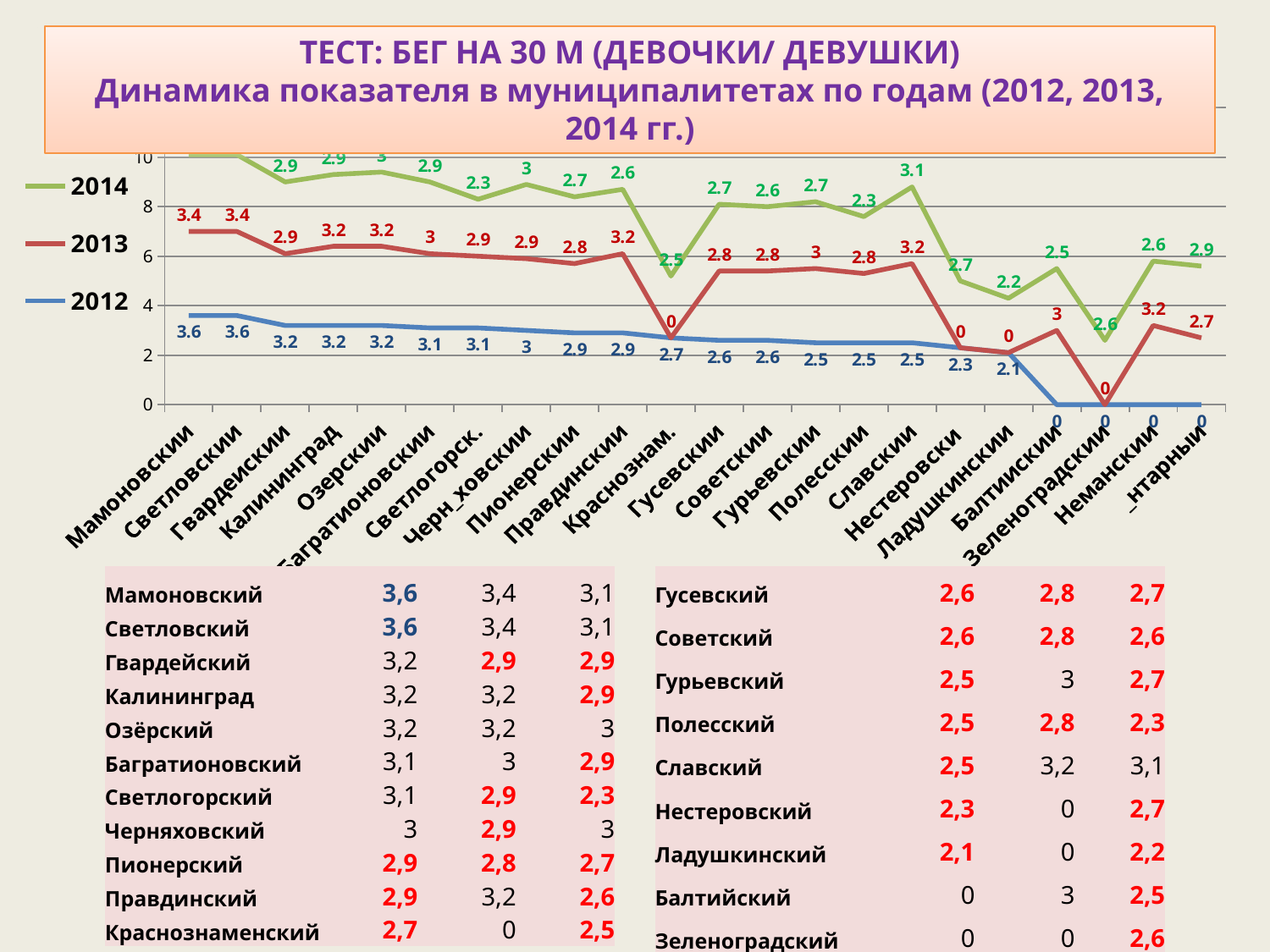
What is the difference between the 2012 values for Мамоновский and Ладушкинский? 1.5 How many municipalities are plotted along the x axis of the chart? 22 How many series does the chart legend list? 3 What is the 2012 value for Мамоновский on the chart? 3.6 What is the 2013 value for Краснознам. on the chart? 0 What is the 2013 value for Балтийский on the chart? 3 What is the 2014 value for Нестеровский on the chart? 2.7 What colour is the line for the 2014 series? green Does the 2012 series rise or fall as you move from left to right along the x axis? fall What kind of chart is shown on the slide? line chart For Калининград, which is larger: the 2013 value or the 2014 value? 2013 What is the 2012 value for Ладушкинский on the chart? 2.1